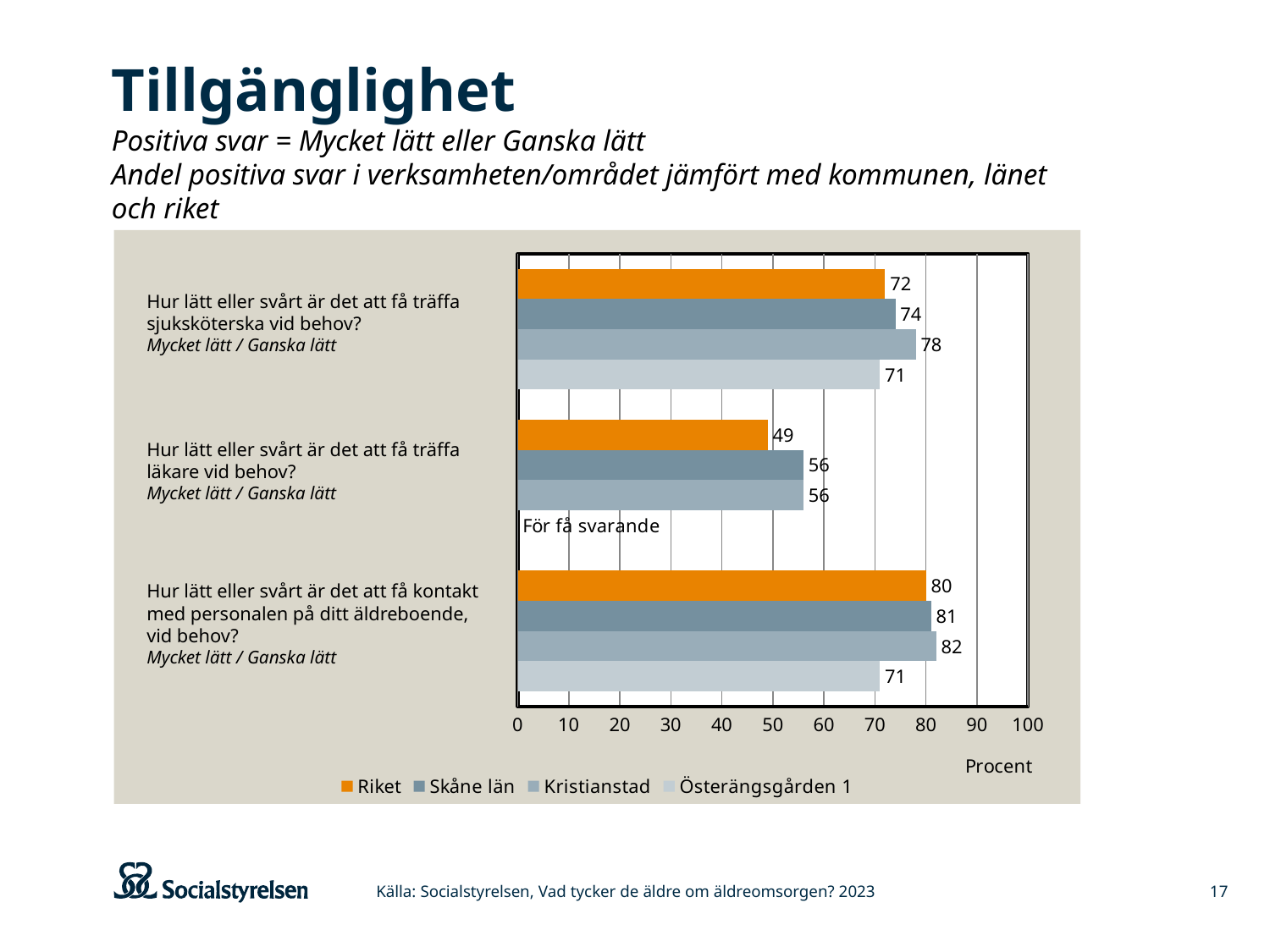
Which series has the highest value for the question about getting to meet a nurse (sjuksköterska) when needed? Kristianstad What is shown for Österängsgården 1 for the question about getting to meet a doctor (läkare) when needed? För få svarande What kind of chart is shown on the slide? Bar chart What is the value for Kristianstad for the question about getting to meet a doctor (läkare) when needed? 56 What is the difference between Kristianstad and Riket for the question about getting to meet a nurse (sjuksköterska) when needed? 6 What is the label on the x axis of the chart? Procent Which series has the lowest value for the question about getting to meet a doctor (läkare) when needed? Riket How many series does the legend list? 4 Which is larger for the question about getting in contact with staff at the care home: Riket or Österängsgården 1? Riket What is the value for Österängsgården 1 for the question about getting in contact with staff at the care home when needed? 71 Is the value for Riket for the question about getting to meet a doctor (läkare) greater or less than 50? less What is the value for Riket for the question about getting to meet a nurse (sjuksköterska) when needed? 72